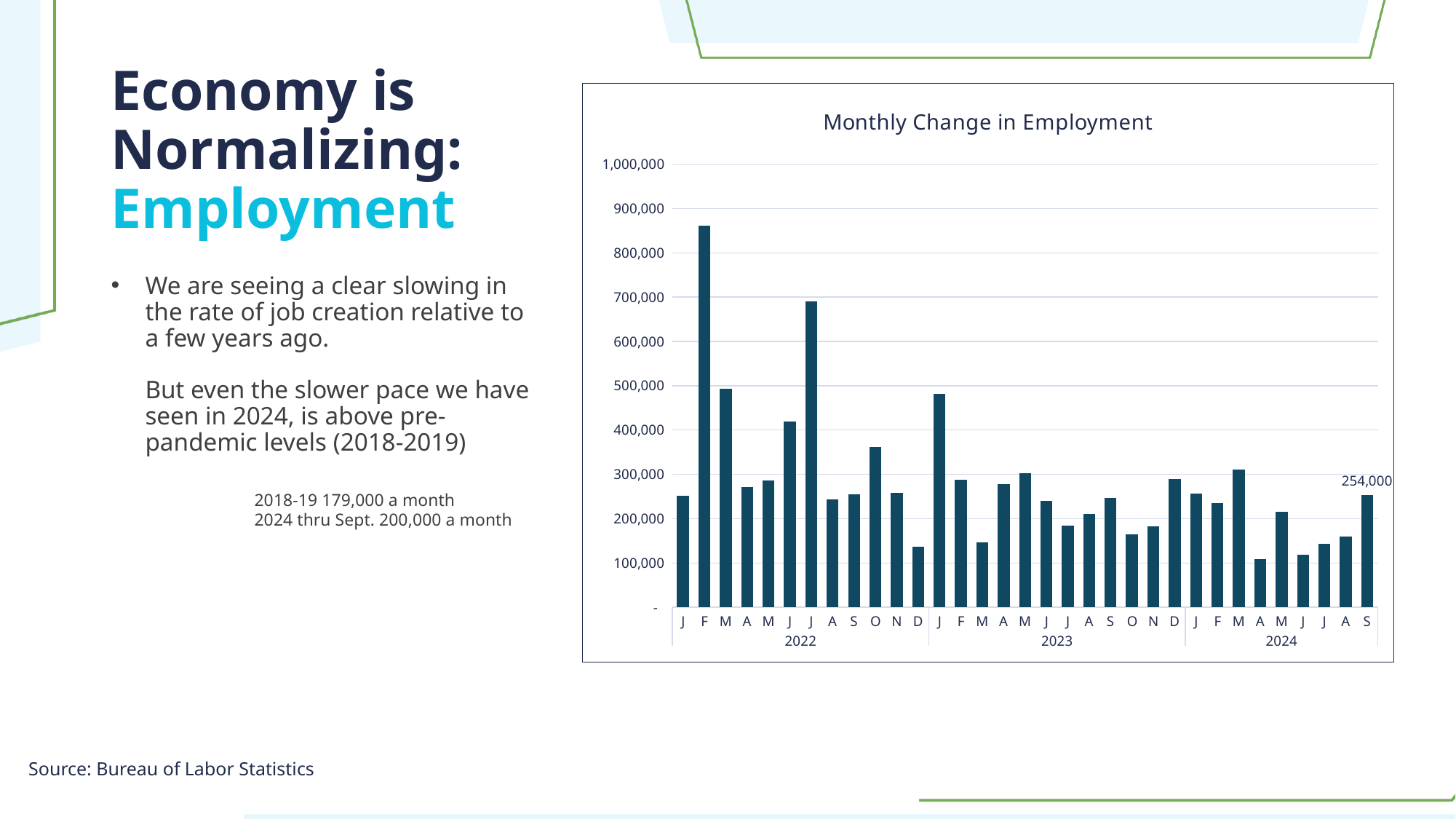
What kind of chart is shown on the slide? bar chart How many years are labelled along the x axis of the chart? 3 Is the value for July 2022 greater or less than 600,000? greater Is the value for April 2024 greater or less than 200,000? less Is the value for February 2022 greater or less than 800,000? greater What is the highest value shown on the chart's vertical axis? 1,000,000 What is the title of the chart? Monthly Change in Employment How many monthly bars are plotted on the chart? 33 Which month has the highest monthly change in employment on the chart? February 2022 Which is larger, the value for February 2022 or the value for July 2022? February 2022 What is the monthly change in employment for September 2024, the last bar on the chart? 254,000